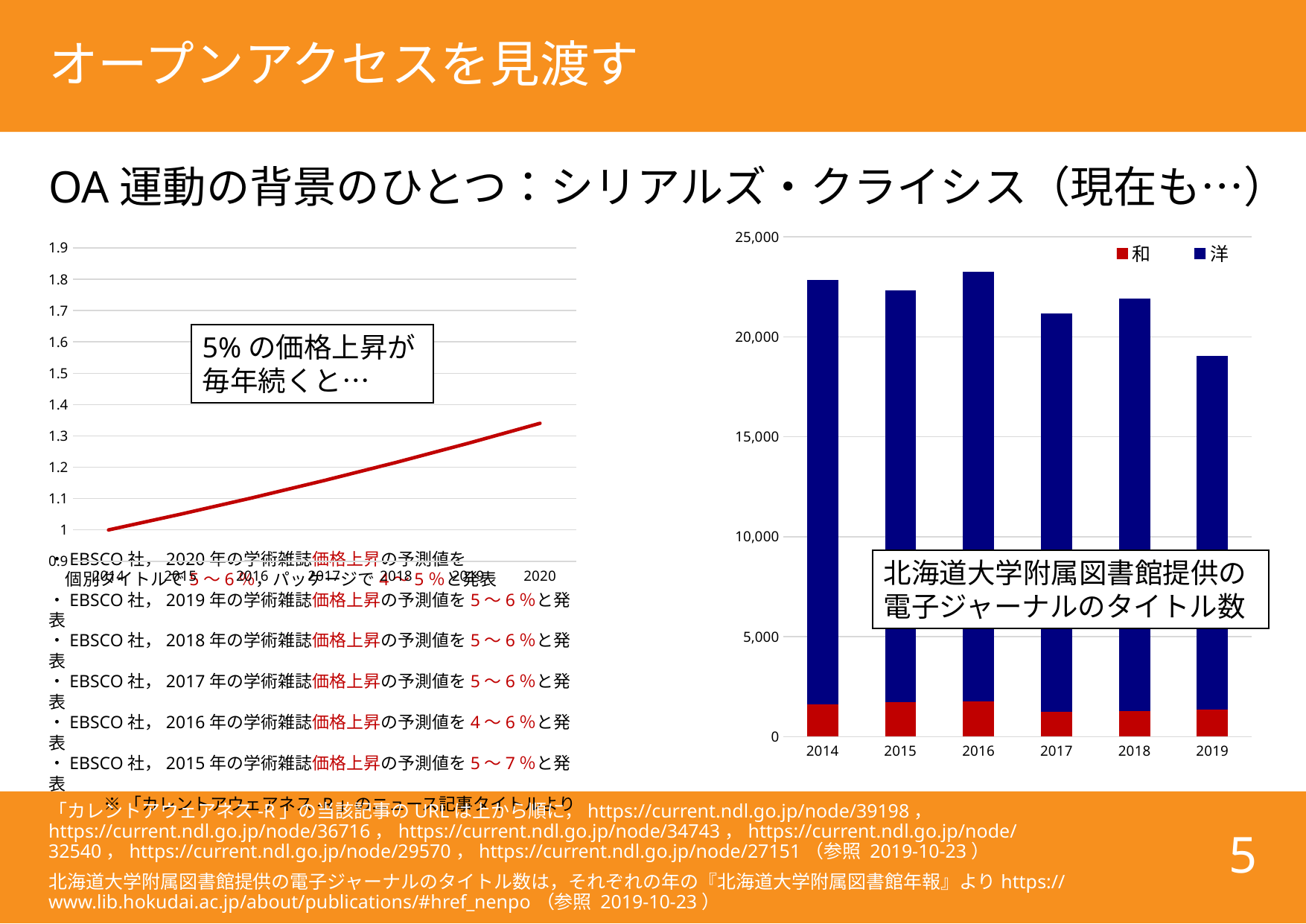
In the bar chart on the right, is the total for 2019 greater or less than 20,000? less In the bar chart on the right, which year has the larger total: 2014 or 2019? 2014 In the line chart on the left, do the values rise or fall from 2014 to 2020? rise In the bar chart on the right, which colour represents the 洋 series? blue In the bar chart on the right, which year has the highest total number of titles? 2016 What kind of chart is the chart on the right of the slide (北海道大学附属図書館提供の電子ジャーナルのタイトル数)? bar chart What kind of chart is the chart on the left of the slide? line chart How many years are shown on the x axis of the bar chart on the right? 6 How many series does the legend of the bar chart on the right list? 2 In the line chart on the left, is the value for 2020 greater or less than 1.3? greater In the bar chart on the right, which year has the lowest total number of titles? 2019 In the line chart on the left, is the value for 2017 greater or less than 1.1? greater